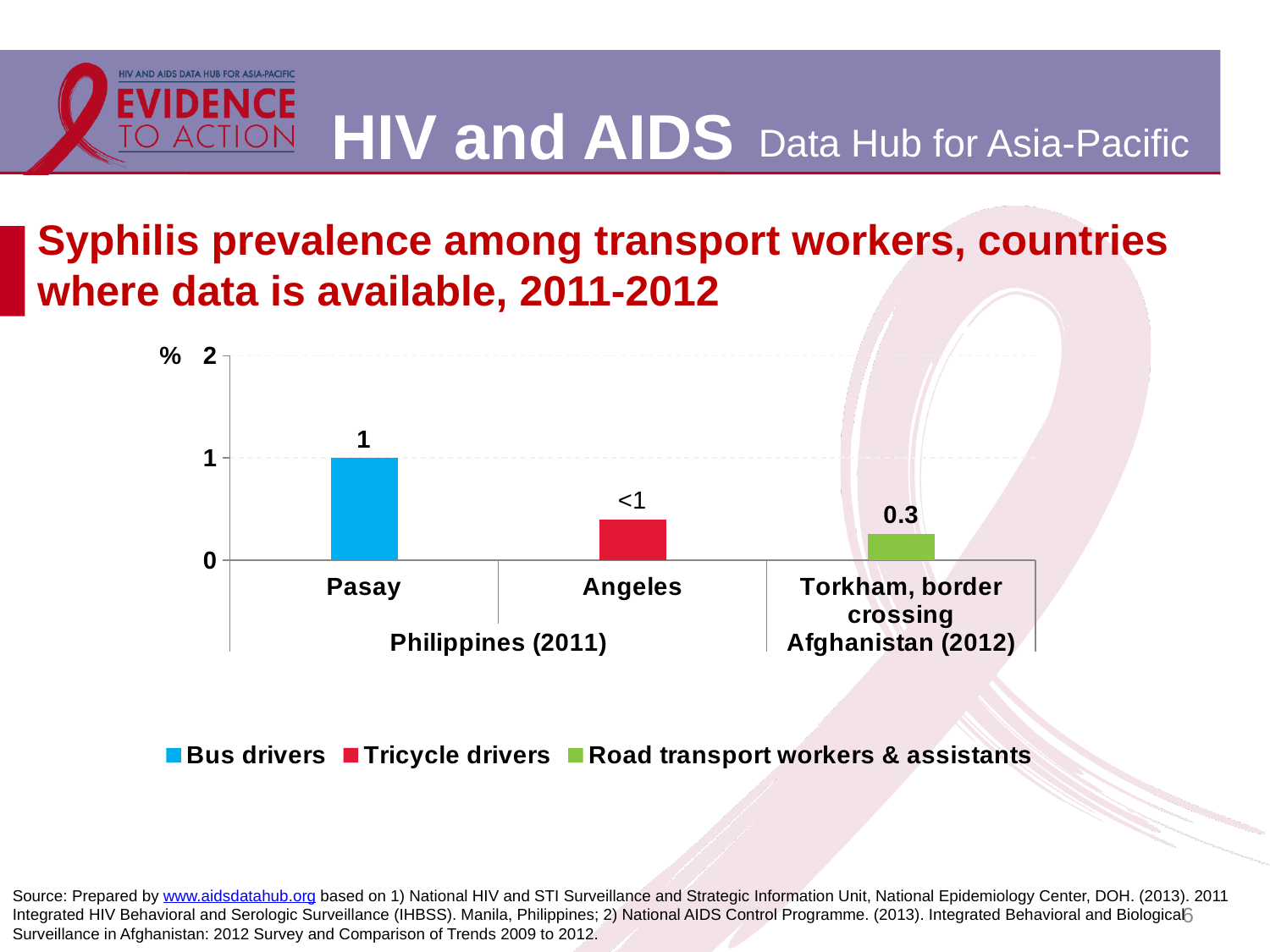
What is the syphilis prevalence value shown for Torkham, border crossing, Afghanistan (2012)? 0.3 Which series does the bar for Torkham, border crossing belong to, according to the legend? Road transport workers & assistants How many series does the legend list? 3 What is the difference between the values for Pasay and Torkham, border crossing? 0.7 Which has a larger value, Pasay or Angeles? Pasay Is the value for Angeles greater or less than 1? less What is the syphilis prevalence value shown for Pasay? 1 Which location has the highest syphilis prevalence in the chart? Pasay What data label is printed above the bar for Angeles? <1 How many locations (bars) are shown in the chart? 3 What kind of chart is shown on the slide? Bar chart Which legend entry is shown in blue? Bus drivers